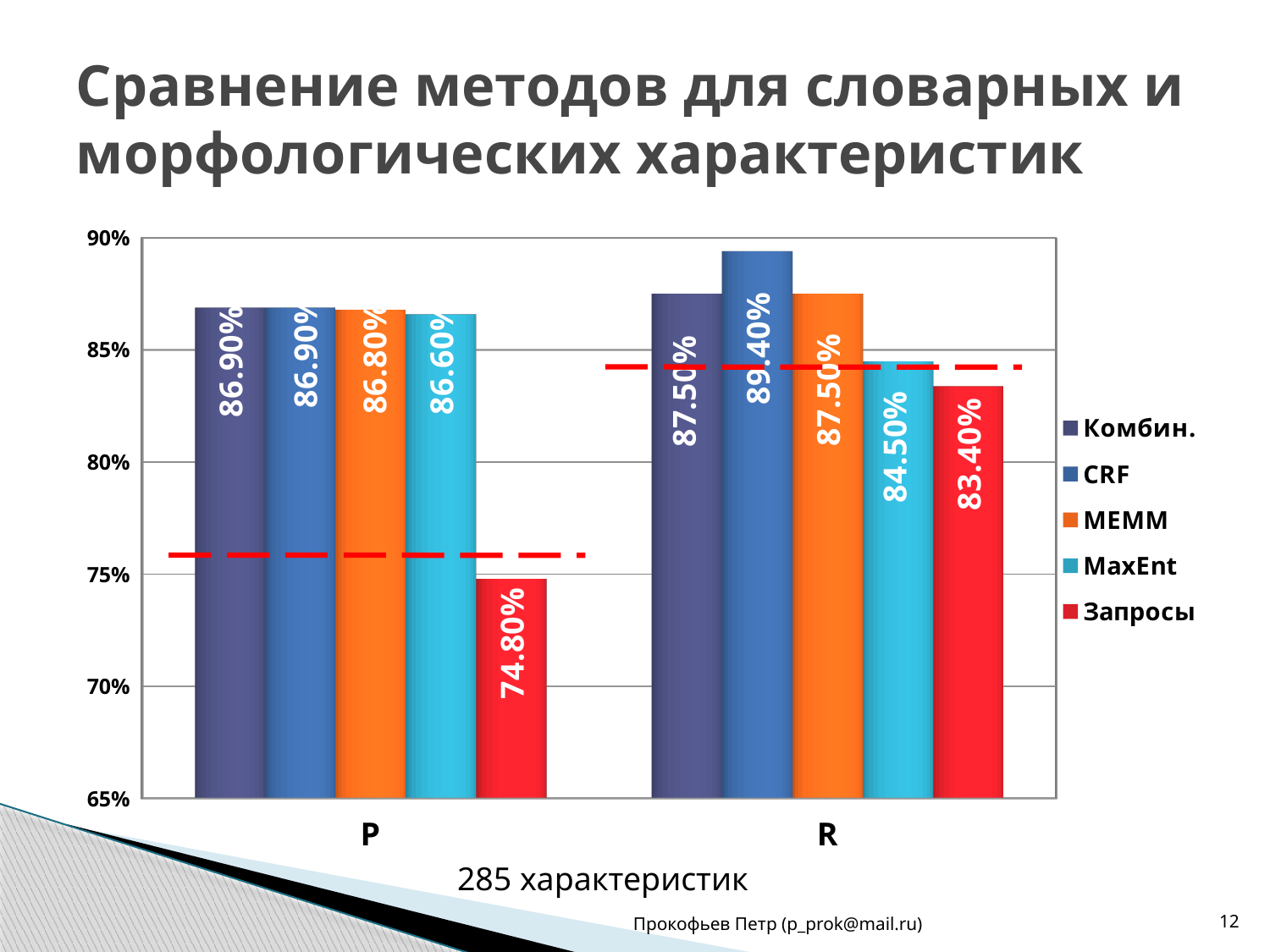
What kind of chart is shown on the slide? Bar chart Which series has the lowest value in category P? Запросы What is the value for CRF in category R? 89.40% Which series has the highest value in category R? CRF What is the value for MaxEnt in category R? 84.50% How many categories are shown on the x axis? 2 Which series is shown in red in the legend? Запросы What is the difference between the CRF value and the Запросы value in category R? 6.00% What is the value for Запросы in category P? 74.80% How many series does the legend list? 5 What is the value for MEMM in category P? 86.80% Which is larger: the MaxEnt value in category P or the MaxEnt value in category R? MaxEnt in category P